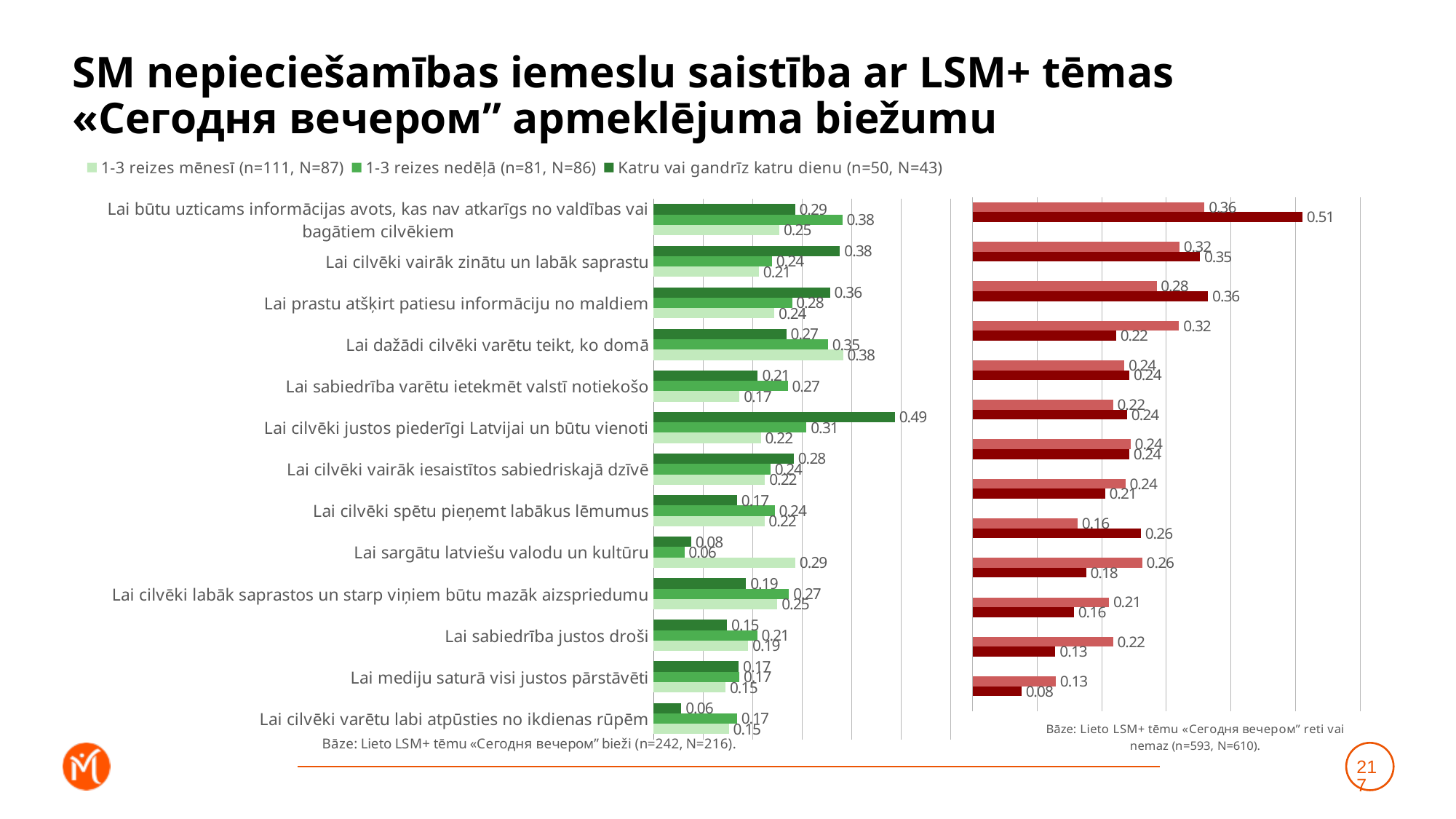
In the right (red) chart, what is the highest value shown, and for which category? 0.51, Lai būtu uzticams informācijas avots, kas nav atkarīgs no valdības vai bagātiem cilvēkiem In the left (green) chart, what is the value for "Lai sargātu latviešu valodu un kultūru" in the series "1-3 reizes mēnesī (n=111, N=87)"? 0.29 In the left (green) chart, for "Lai dažādi cilvēki varētu teikt, ko domā", which series has the larger value: "1-3 reizes mēnesī" or "Katru vai gandrīz katru dienu"? 1-3 reizes mēnesī In the left (green) chart, which category has the highest value in the series "Katru vai gandrīz katru dienu (n=50, N=43)"? Lai cilvēki justos piederīgi Latvijai un būtu vienoti What kind of chart is the left (green) chart? Bar chart What base (Bāze) is stated below the right (red) chart? Lieto LSM+ tēmu «Сегодня вечером» reti vai nemaz (n=593, N=610). In the left (green) chart, what is the value for "Lai būtu uzticams informācijas avots, kas nav atkarīgs no valdības vai bagātiem cilvēkiem" in the series "1-3 reizes nedēļā (n=81, N=86)"? 0.38 In the left (green) chart, which category has the lowest value in the series "Katru vai gandrīz katru dienu (n=50, N=43)"? Lai cilvēki varētu labi atpūsties no ikdienas rūpēm In the left (green) chart, what is the value for "Lai cilvēki justos piederīgi Latvijai un būtu vienoti" in the series "Katru vai gandrīz katru dienu (n=50, N=43)"? 0.49 How many series does the legend of the left (green) chart list? 3 How many categories are listed in the left (green) chart? 13 In the left (green) chart, what is the difference between the "Katru vai gandrīz katru dienu" value and the "1-3 reizes mēnesī" value for "Lai cilvēki justos piederīgi Latvijai un būtu vienoti"? 0.27